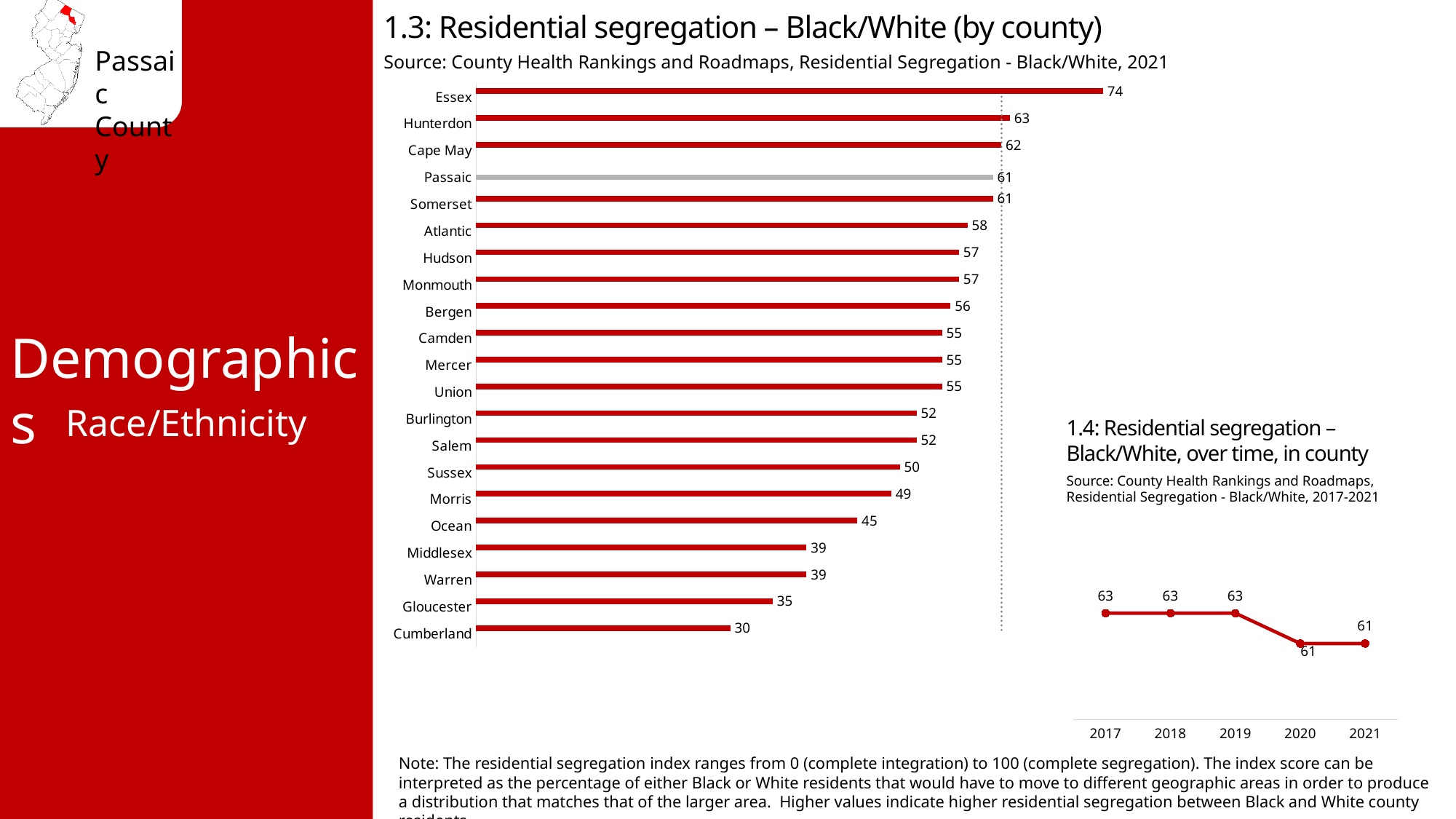
How many years are plotted in the chart '1.4: Residential segregation – Black/White, over time, in county'? 5 In the chart '1.3: Residential segregation – Black/White (by county)', what is the value for Passaic? 61 In the chart '1.3: Residential segregation – Black/White (by county)', which county has the lowest value? Cumberland In the chart '1.4: Residential segregation – Black/White, over time, in county', do the values rise or fall from 2019 to 2020? fall In the chart '1.3: Residential segregation – Black/White (by county)', what is the difference between the values for Essex and Cumberland? 44 How many counties are shown in the chart '1.3: Residential segregation – Black/White (by county)'? 21 In the chart '1.4: Residential segregation – Black/White, over time, in county', what is the value for 2017? 63 In the chart '1.3: Residential segregation – Black/White (by county)', which county has the highest value? Essex What kind of chart is '1.3: Residential segregation – Black/White (by county)'? bar chart In the chart '1.4: Residential segregation – Black/White, over time, in county', what is the value for 2021? 61 In the chart '1.3: Residential segregation – Black/White (by county)', which has a larger value, Hunterdon or Ocean? Hunterdon In the chart '1.3: Residential segregation – Black/White (by county)', what is the value for Essex? 74